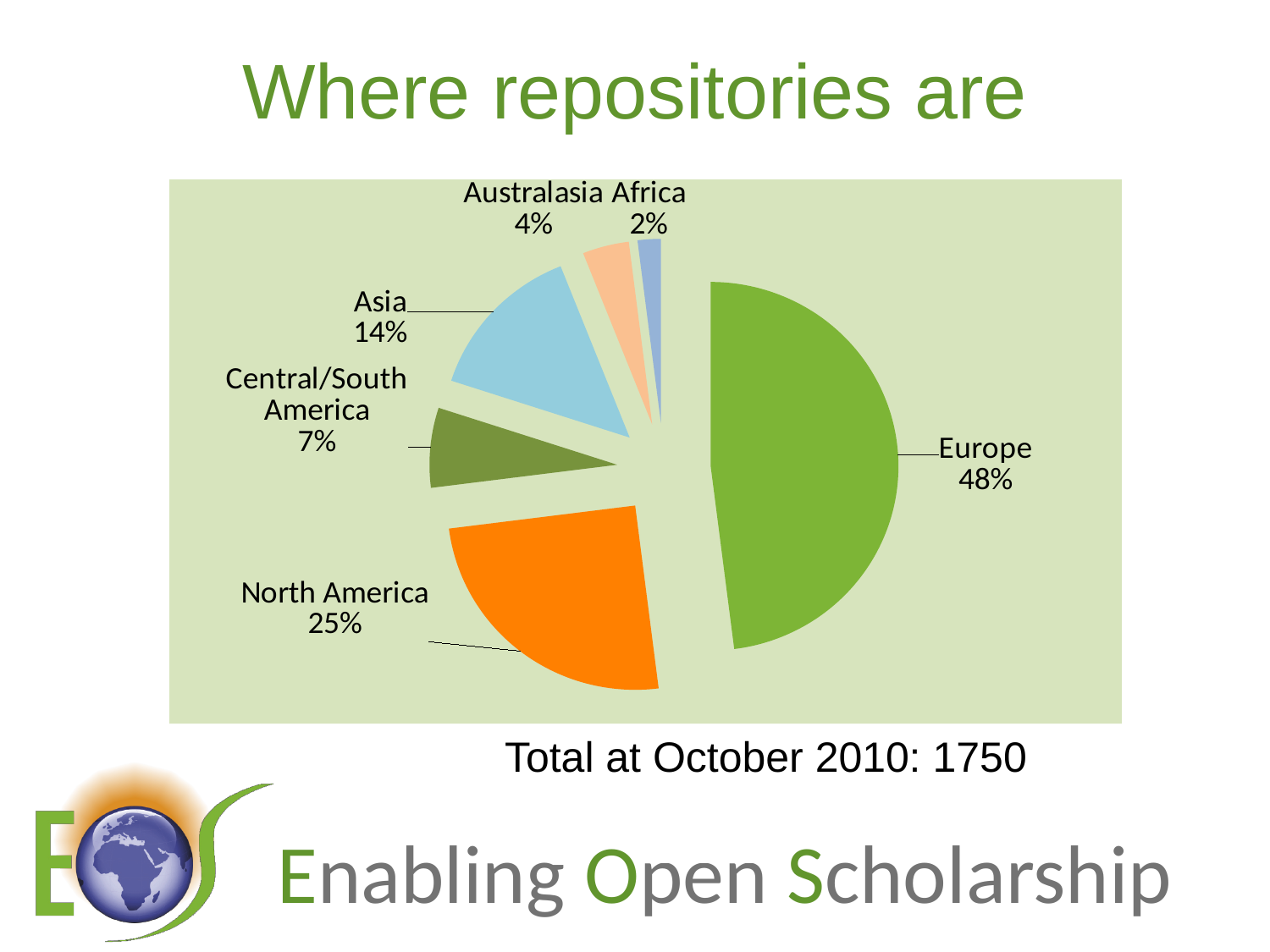
What share of repositories is in Europe? 48% What kind of chart is shown on the slide? Pie chart What share of repositories is in Australasia? 4% What is the difference in percentage points between Europe's share and North America's share? 23 What share of repositories is in Asia? 14% What share of repositories is in North America? 25% How many regions are shown in the pie chart? 6 What share of repositories is in Central/South America? 7% Which region has the smallest share of repositories? Africa Which region has the largest share of repositories? Europe What is the total number of repositories stated on the slide for October 2010? 1750 Which has a larger share of repositories, Asia or Central/South America? Asia